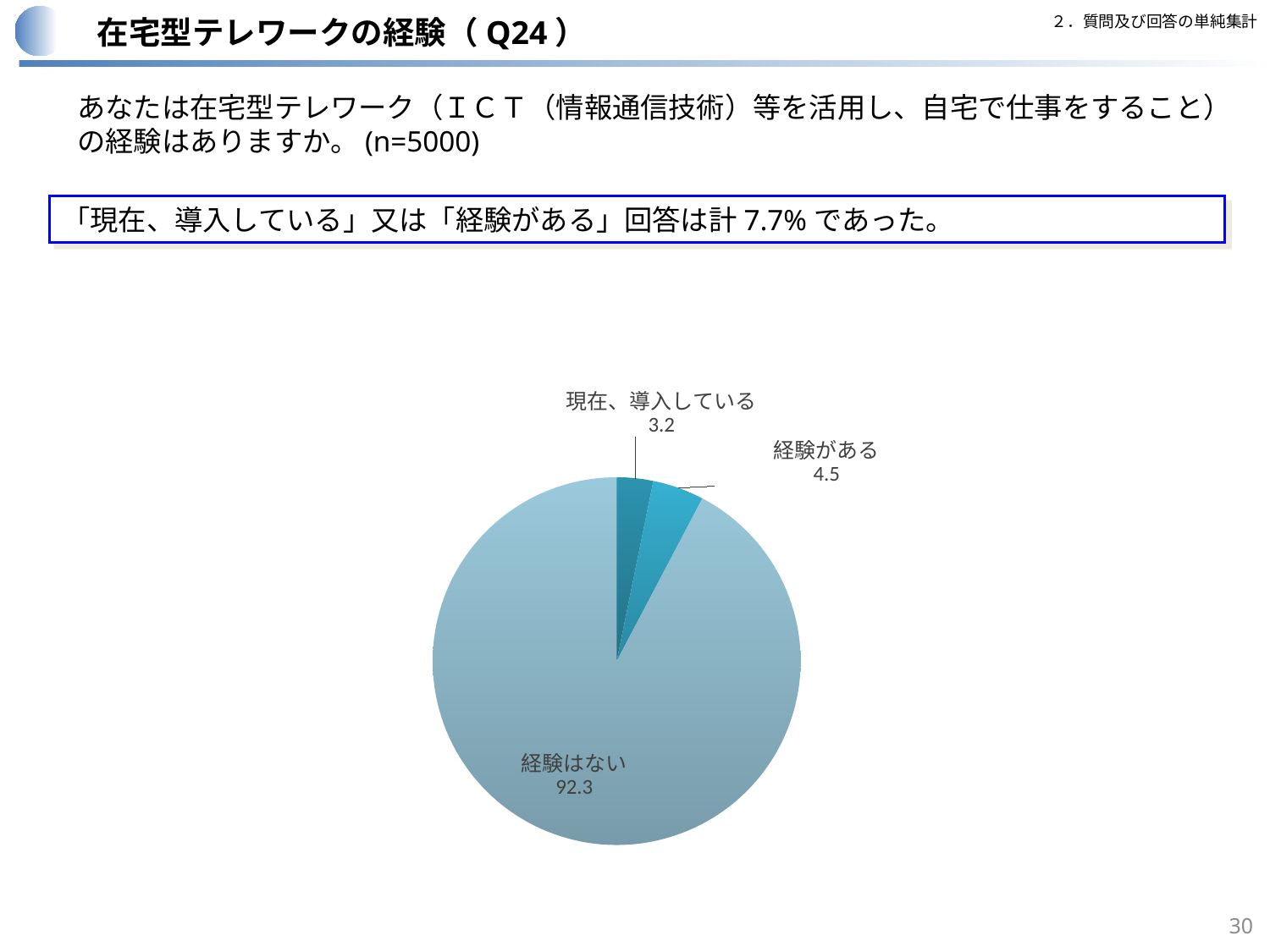
What is the value for 経験はない? 92.3 What is the difference between the values for 経験がある and 現在、導入している? 1.3 What is the sample size (n) stated on the slide for this question? 5000 Which is larger, the value for 経験がある or the value for 現在、導入している? 経験がある What is the difference between the values for 経験はない and 経験がある? 87.8 What kind of chart is shown on the slide? pie chart What is the value for 現在、導入している? 3.2 What is the combined value of 現在、導入している and 経験がある? 7.7 How many categories are shown in the pie chart? 3 Which category has the smallest slice? 現在、導入している Which category has the largest slice? 経験はない What is the value for 経験がある? 4.5